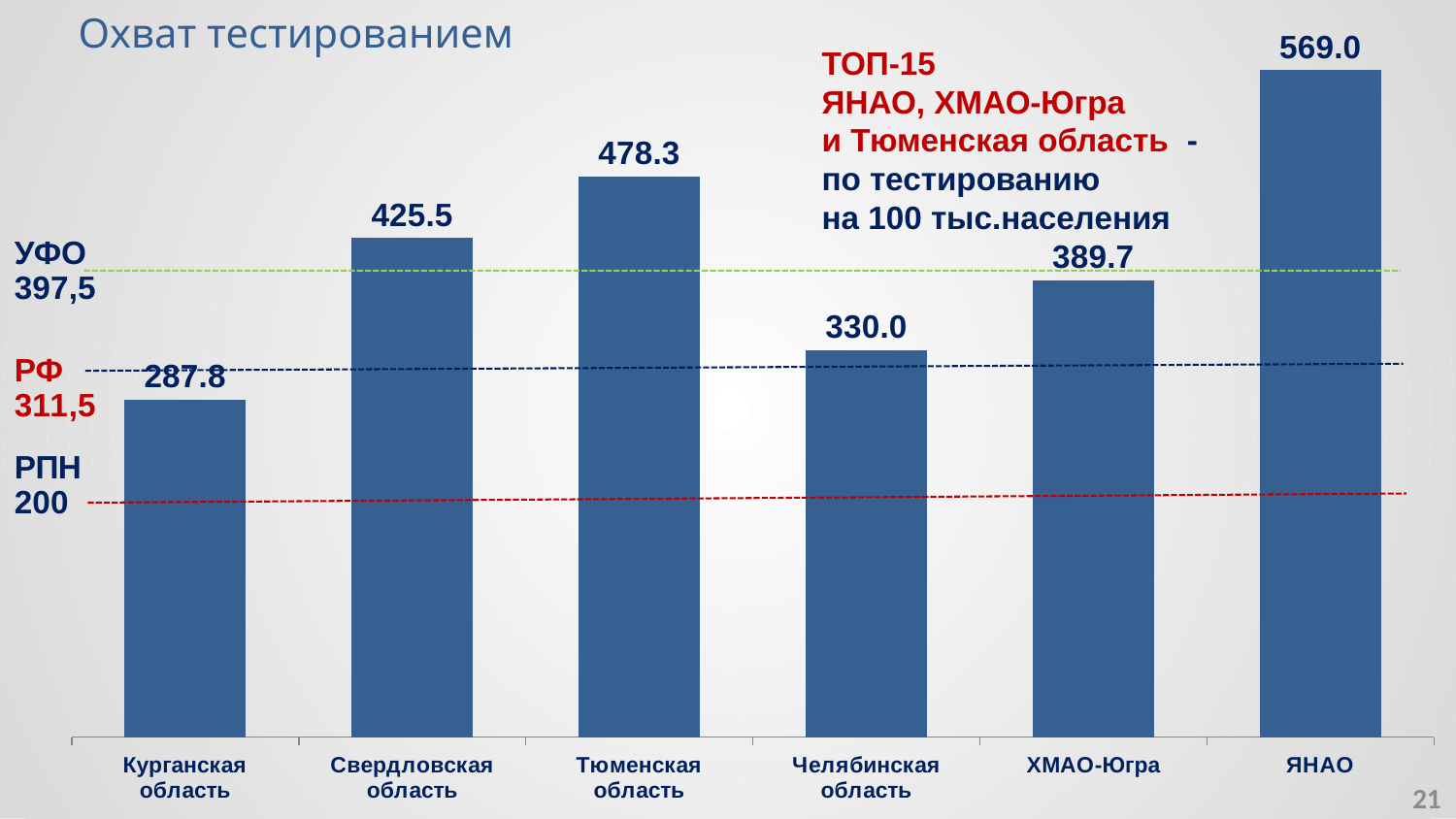
What value is marked by the УФО reference line? 397,5 What is the title of the slide's chart? Охват тестированием Which category has the lowest value? Курганская область How many categories are shown on the x axis? 6 What is the difference between the values for Свердловская область and Челябинская область? 95.5 What is the value for Тюменская область? 478.3 What is the value for Курганская область? 287.8 What kind of chart is shown on the slide? bar chart Which category has the highest value? ЯНАО What is the difference between the values for ЯНАО and Тюменская область? 90.7 What is the value for ХМАО-Югра? 389.7 Which is larger, the value for Свердловская область or the value for ХМАО-Югра? Свердловская область